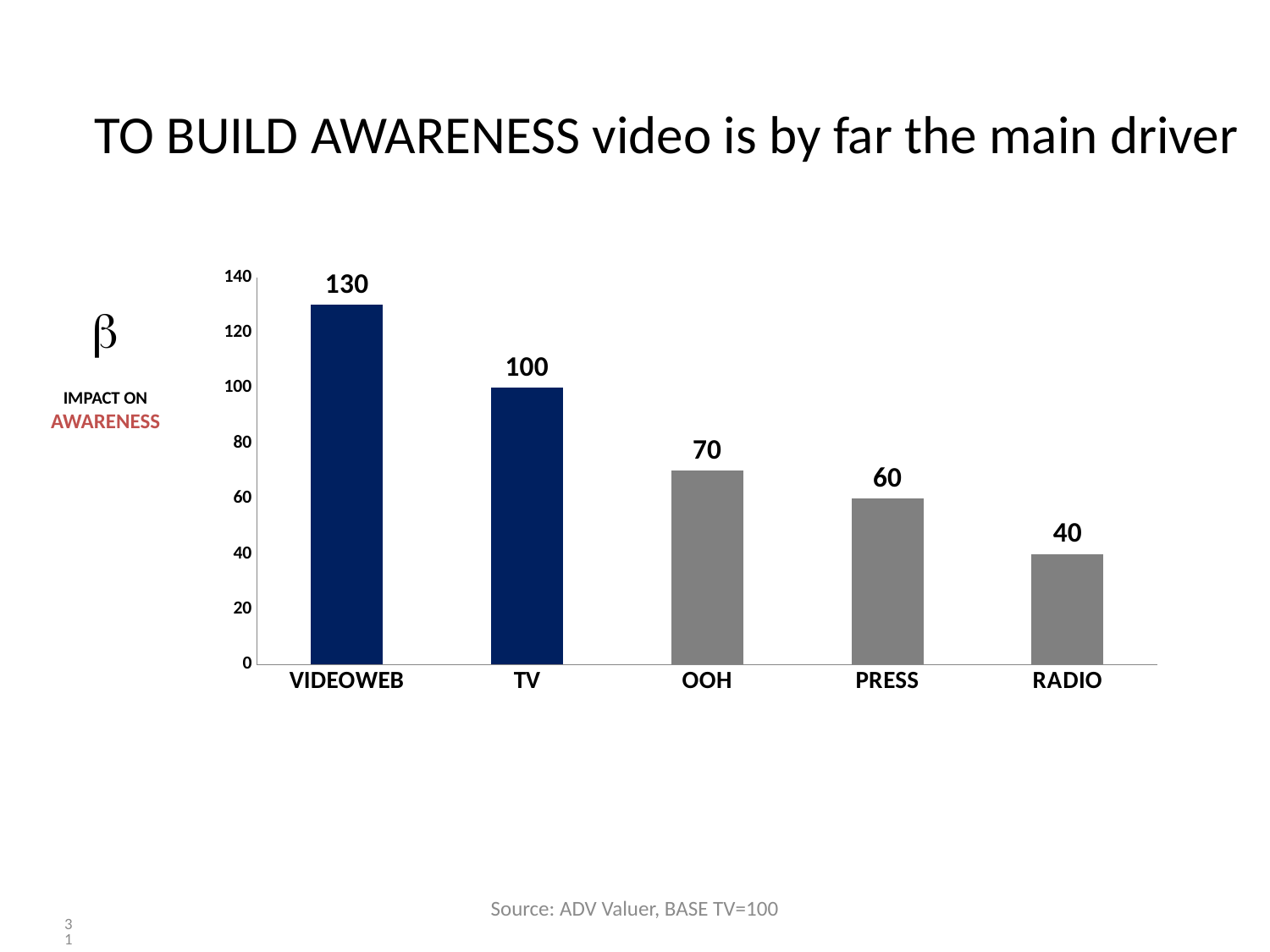
Do the values rise or fall from left to right along the x axis? fall What is the difference between the values for PRESS and RADIO? 20 What is the value for VIDEOWEB? 130 What is the value for RADIO? 40 How many categories are shown on the x axis? 5 Is the value for TV greater or less than 80? greater What kind of chart is shown on the slide? bar chart What is the value for OOH? 70 Which category has the lowest value? RADIO Which category has the highest value? VIDEOWEB What is the difference between the values for VIDEOWEB and TV? 30 Which is larger, the value for OOH or the value for PRESS? OOH